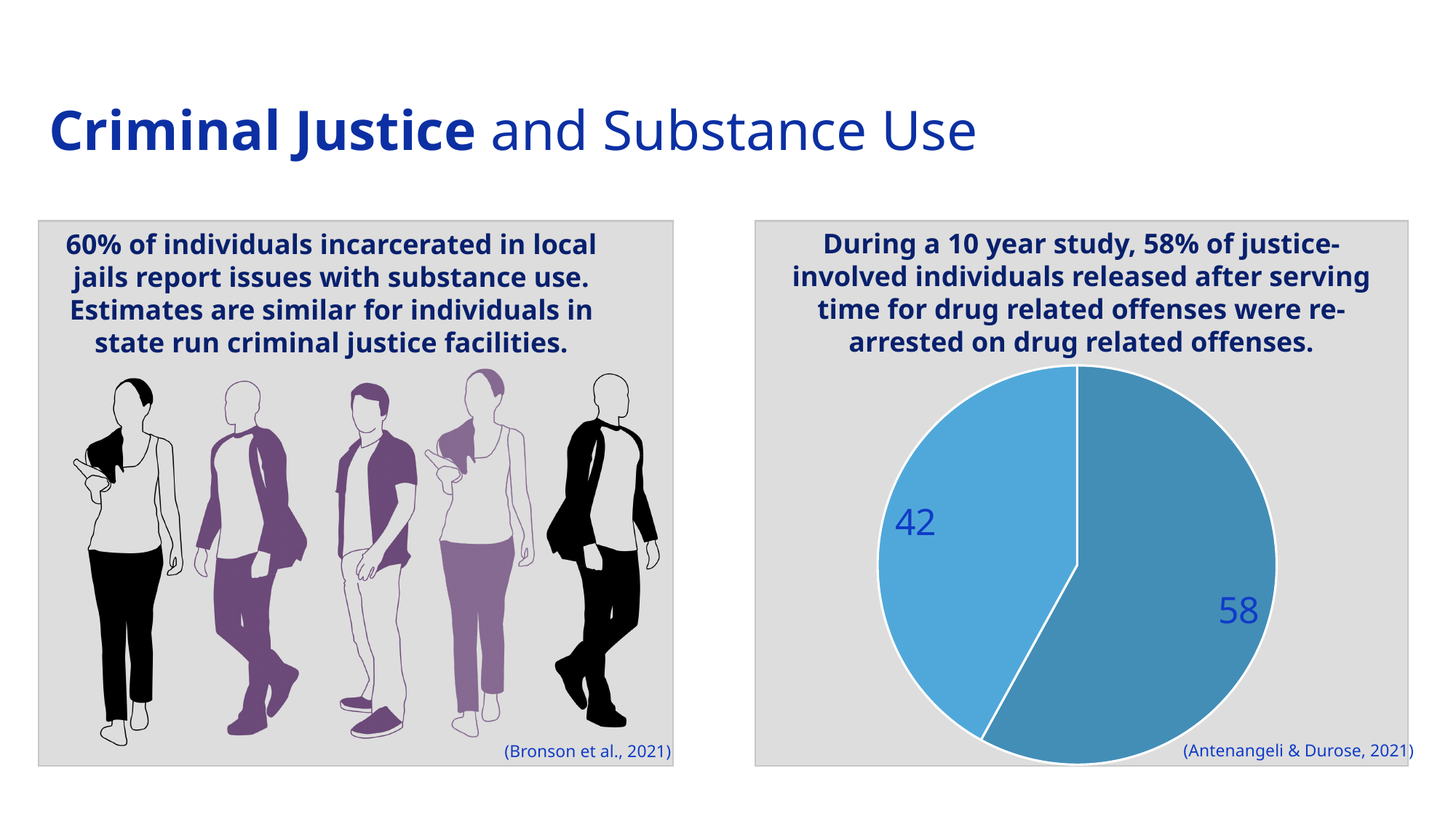
What value is printed on the lighter blue slice of the pie chart? 42 What share of the pie does the slice labelled 58 represent? 58% Is the value on the darker blue slice larger or smaller than the value on the lighter blue slice? larger Does the pie chart include a legend? No Which slice of the pie chart is the smallest, the darker blue one or the lighter blue one? the lighter blue one What is the difference between the two values shown on the pie chart? 16 What value is printed on the darker blue slice of the pie chart? 58 What kind of chart is shown on the right side of the slide? pie chart Which slice of the pie chart is the largest, the darker blue one or the lighter blue one? the darker blue one What is the total of the two values shown on the pie chart? 100 What source citation is shown beneath the pie chart? (Antenangeli & Durose, 2021) How many slices does the pie chart have? 2